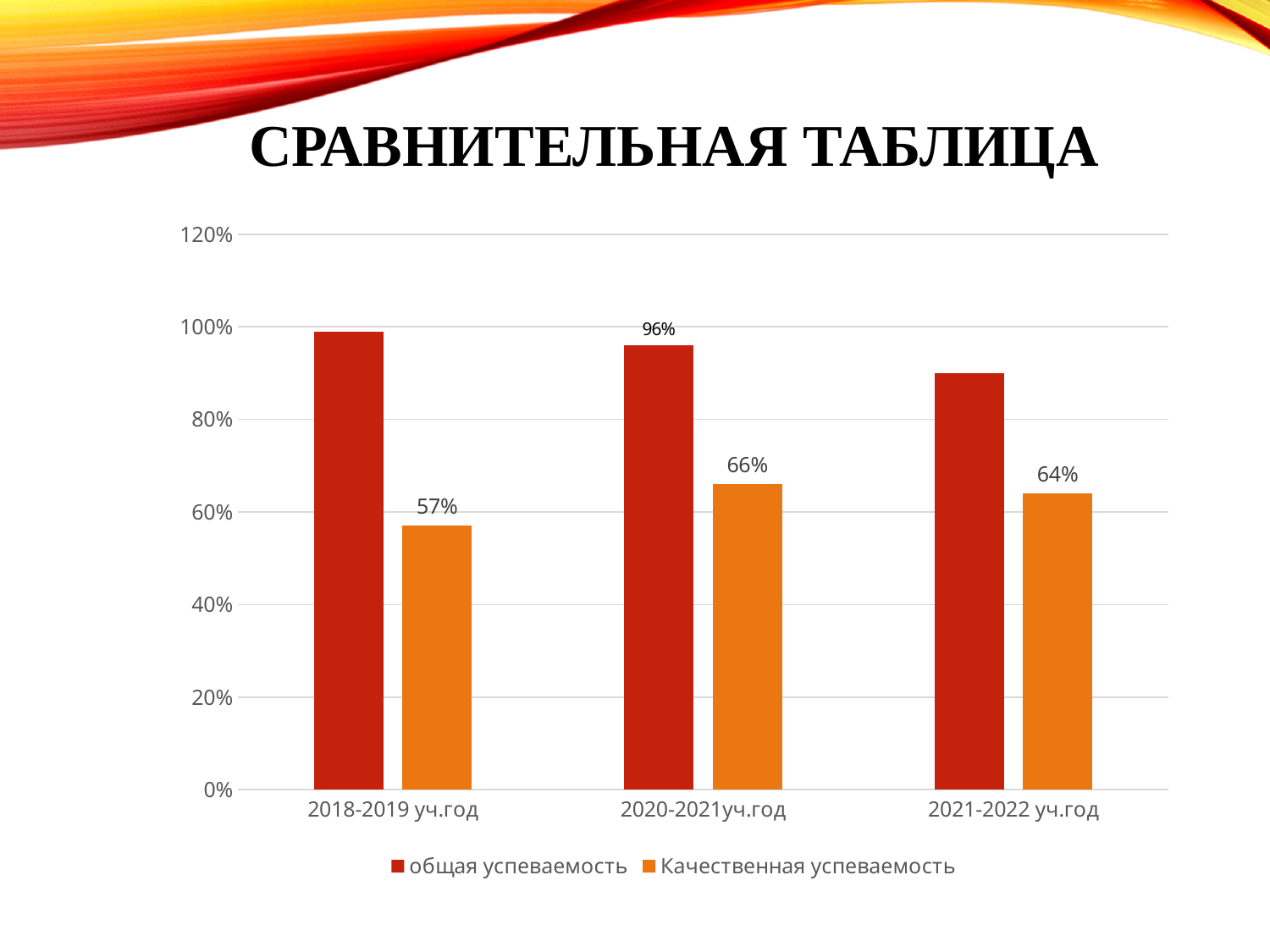
Which is larger: Качественная успеваемость in 2020-2021уч.год or in 2021-2022 уч.год? 2020-2021уч.год What is the value of Качественная успеваемость for 2018-2019 уч.год? 57% Does общая успеваемость rise or fall across the years from 2018-2019 уч.год to 2021-2022 уч.год? fall What is the value of Качественная успеваемость for 2020-2021уч.год? 66% What is the difference between Качественная успеваемость in 2020-2021уч.год and in 2018-2019 уч.год? 9% In which year is Качественная успеваемость lowest? 2018-2019 уч.год How many academic years are shown on the x axis? 3 In which year is Качественная успеваемость highest? 2020-2021уч.год How many series does the legend list? 2 What is the value of общая успеваемость for 2020-2021уч.год? 96% What kind of chart is shown on the slide? bar chart Is the value of общая успеваемость for 2021-2022 уч.год greater or less than 80%? greater